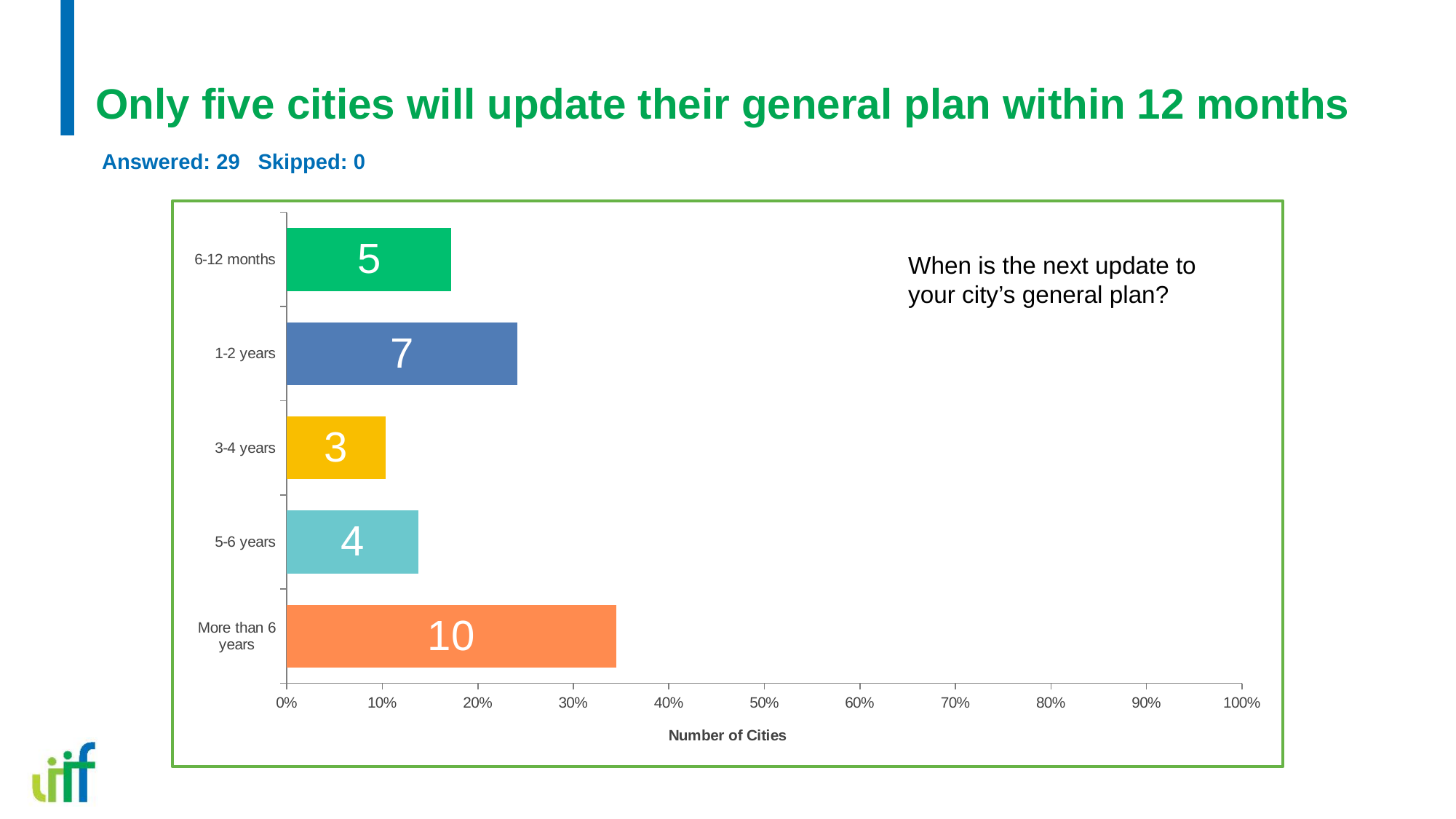
Is the bar for "More than 6 years" greater or less than 30% on the axis? greater What is the value shown for the "More than 6 years" category? 10 Which category has the lowest value? 3-4 years What is the label on the horizontal axis of the chart? Number of Cities What kind of chart is shown on the slide? bar chart What is the value shown for the "1-2 years" category? 7 What is the value shown for the "6-12 months" category? 5 Which category has the highest value? More than 6 years Which is larger, the value for "5-6 years" or the value for "3-4 years"? 5-6 years What is the difference between the values for "More than 6 years" and "1-2 years"? 3 What is the total of all the values labelled on the bars? 29 How many categories are shown in the chart? 5